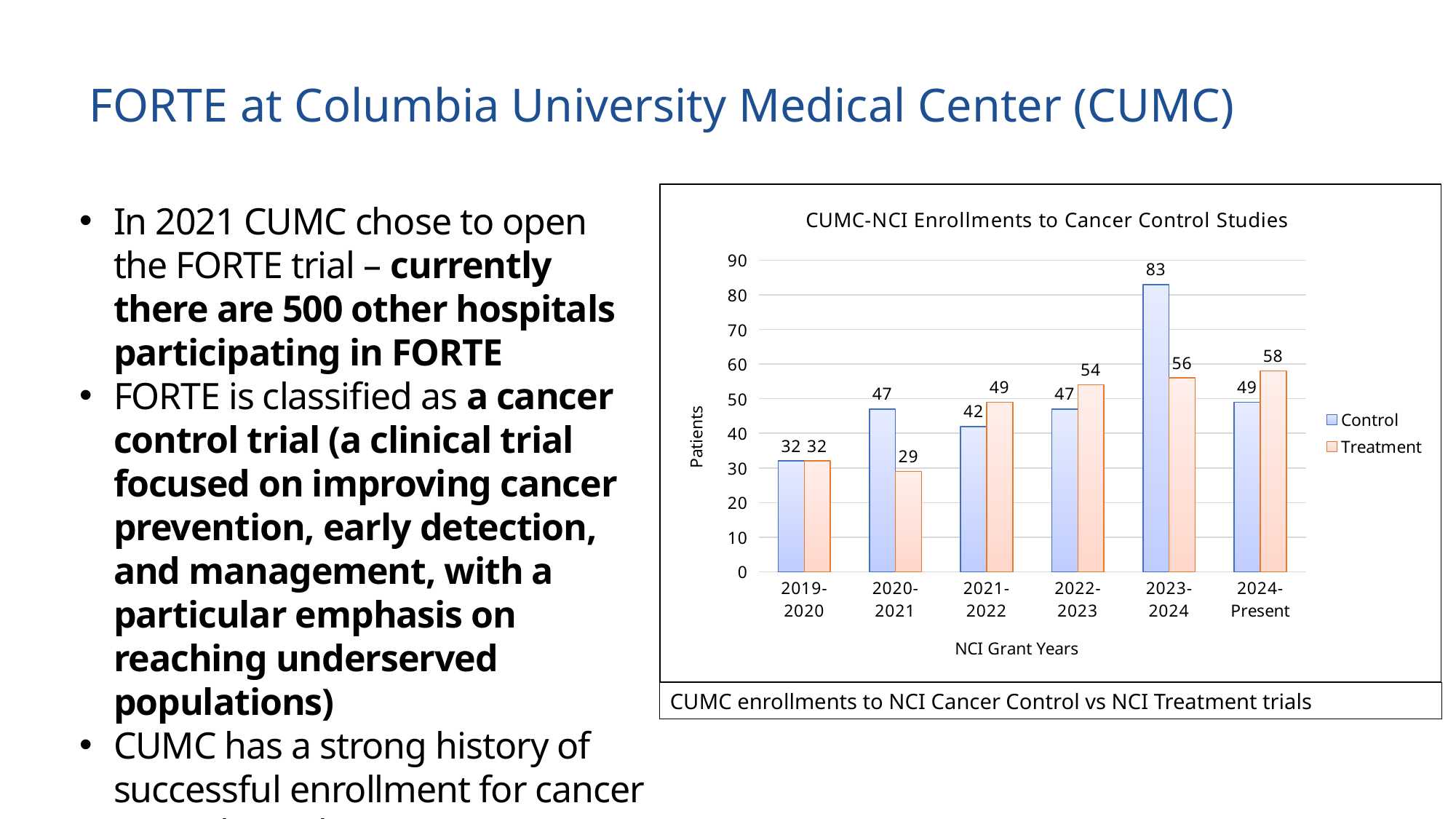
Is the Control value for 2023-2024 greater or less than 80? greater What is the Treatment value for 2024-Present? 58 Which NCI grant year has the highest Control value? 2023-2024 How many series does the legend list? 2 What is the Treatment value for 2020-2021? 29 What is the Control value for 2023-2024? 83 What is the difference between the Control and Treatment values for 2023-2024? 27 What kind of chart is shown on the slide? bar chart How many NCI grant year categories are shown on the x axis? 6 What is the title of the chart? CUMC-NCI Enrollments to Cancer Control Studies Which is larger for 2021-2022, the Control value or the Treatment value? Treatment Which NCI grant year has the lowest Treatment value? 2020-2021